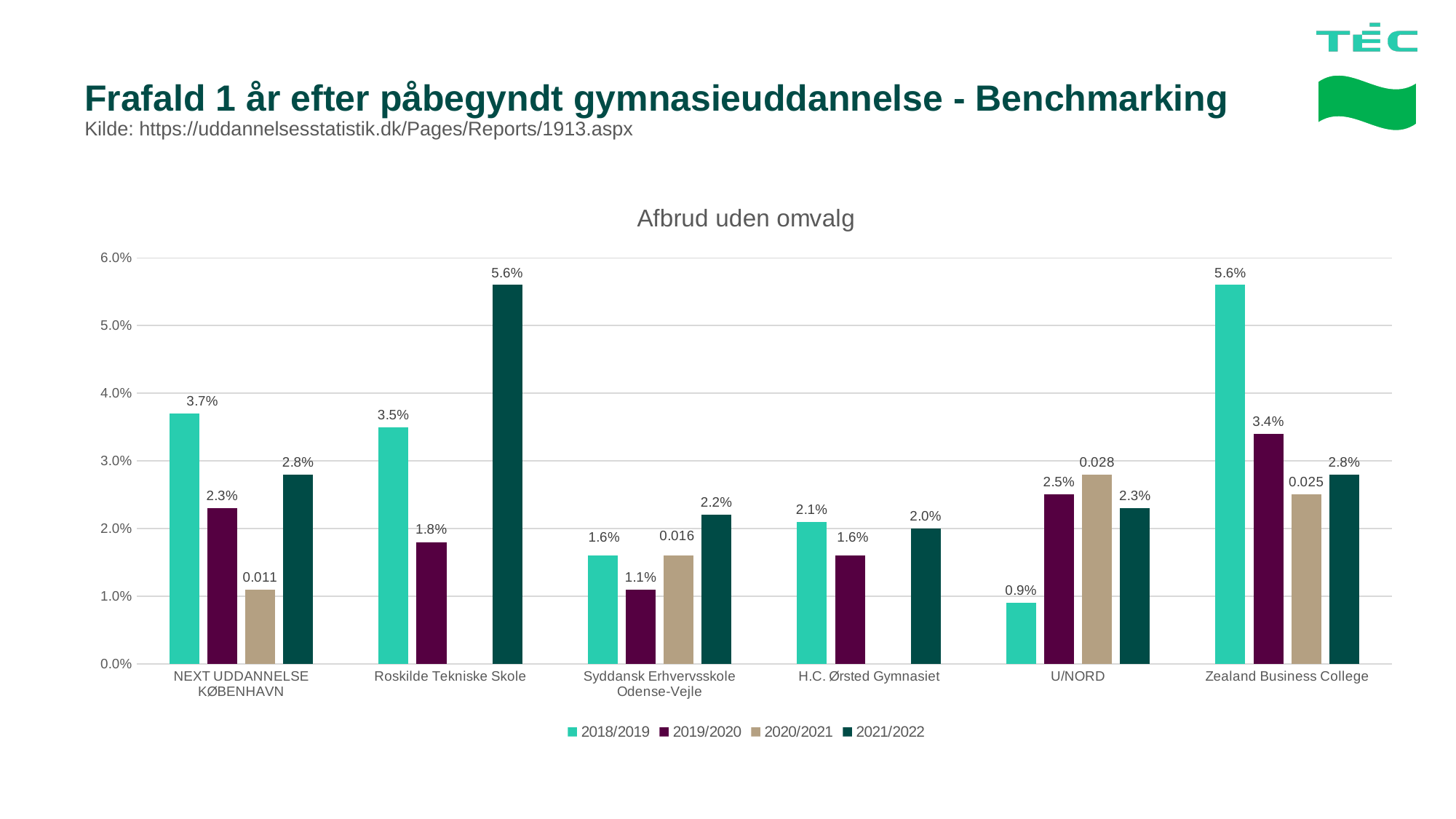
Which is larger for U/NORD: the 2019/2020 value or the 2021/2022 value? 2019/2020 Which category has the lowest value in the 2018/2019 series? U/NORD How many categories (schools) are shown on the x axis? 6 What is the difference between the 2018/2019 and 2019/2020 values for Zealand Business College? 2.2% How many series does the legend list? 4 What is the value for H.C. Ørsted Gymnasiet in the 2019/2020 series? 1.6% Is the 2021/2022 value for Roskilde Tekniske Skole greater or less than 5.0%? greater What is the value for NEXT UDDANNELSE KØBENHAVN in the 2018/2019 series? 3.7% What is the value for Roskilde Tekniske Skole in the 2021/2022 series? 5.6% What is the title of the chart? Afbrud uden omvalg Which category has the highest value in the 2018/2019 series? Zealand Business College What is the data label shown for U/NORD in the 2020/2021 series? 0.028